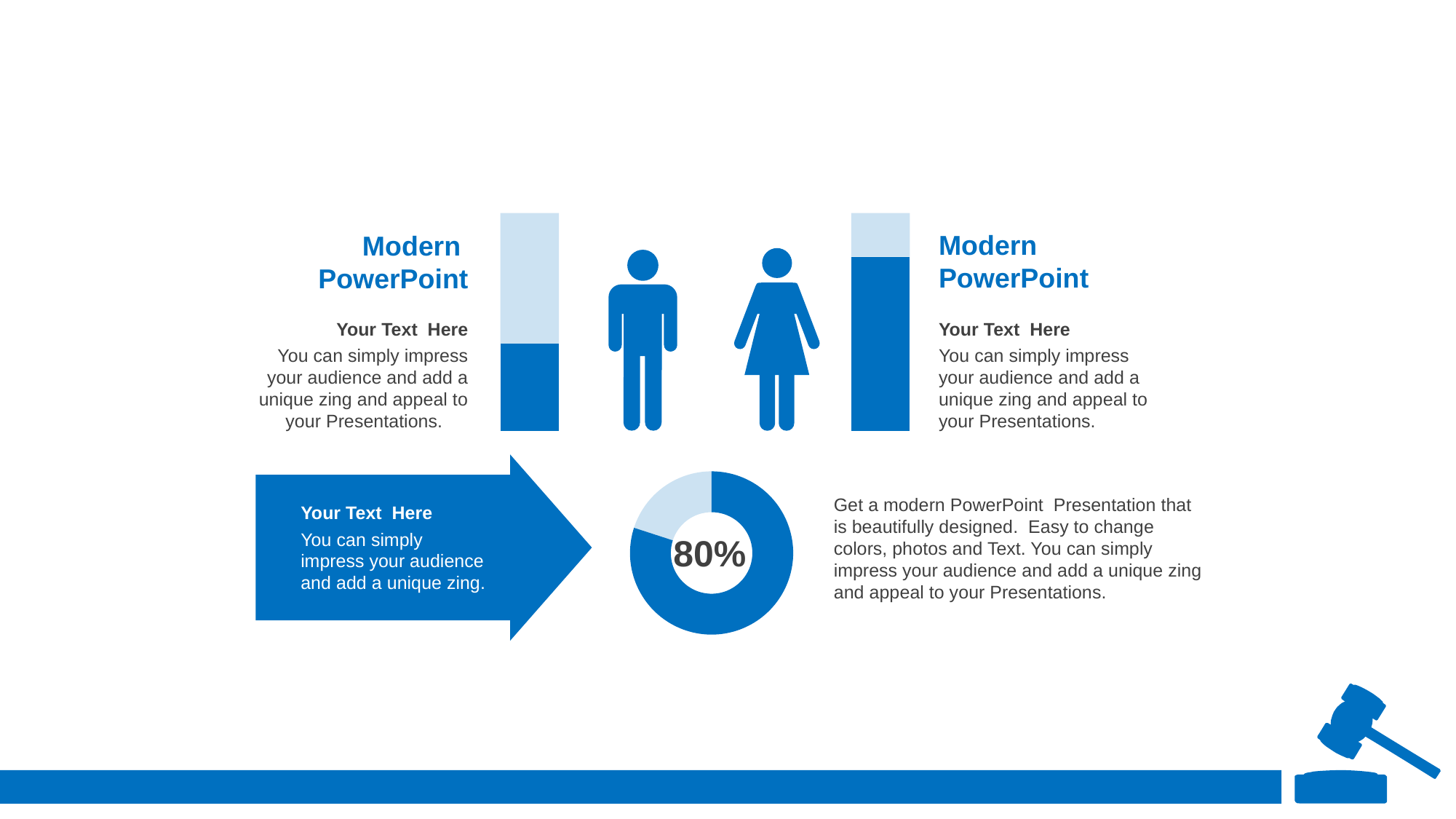
What percentage is printed in the centre of the donut chart? 80% Of the two vertical bars beside the person icons, which one has the larger dark blue filled portion, the left bar or the right bar? the right bar What colour is the larger segment of the donut chart? dark blue What share of the donut chart does the dark blue segment represent? 80% In the donut chart, which segment is larger, the dark blue one or the light blue one? dark blue Is the dark blue share of the donut chart greater or less than 50%? greater What kind of chart is shown in the centre of the slide with the 80% label? donut chart How many segments does the donut chart have? 2 How many vertical bars are shown beside the person icons in the upper part of the slide? 2